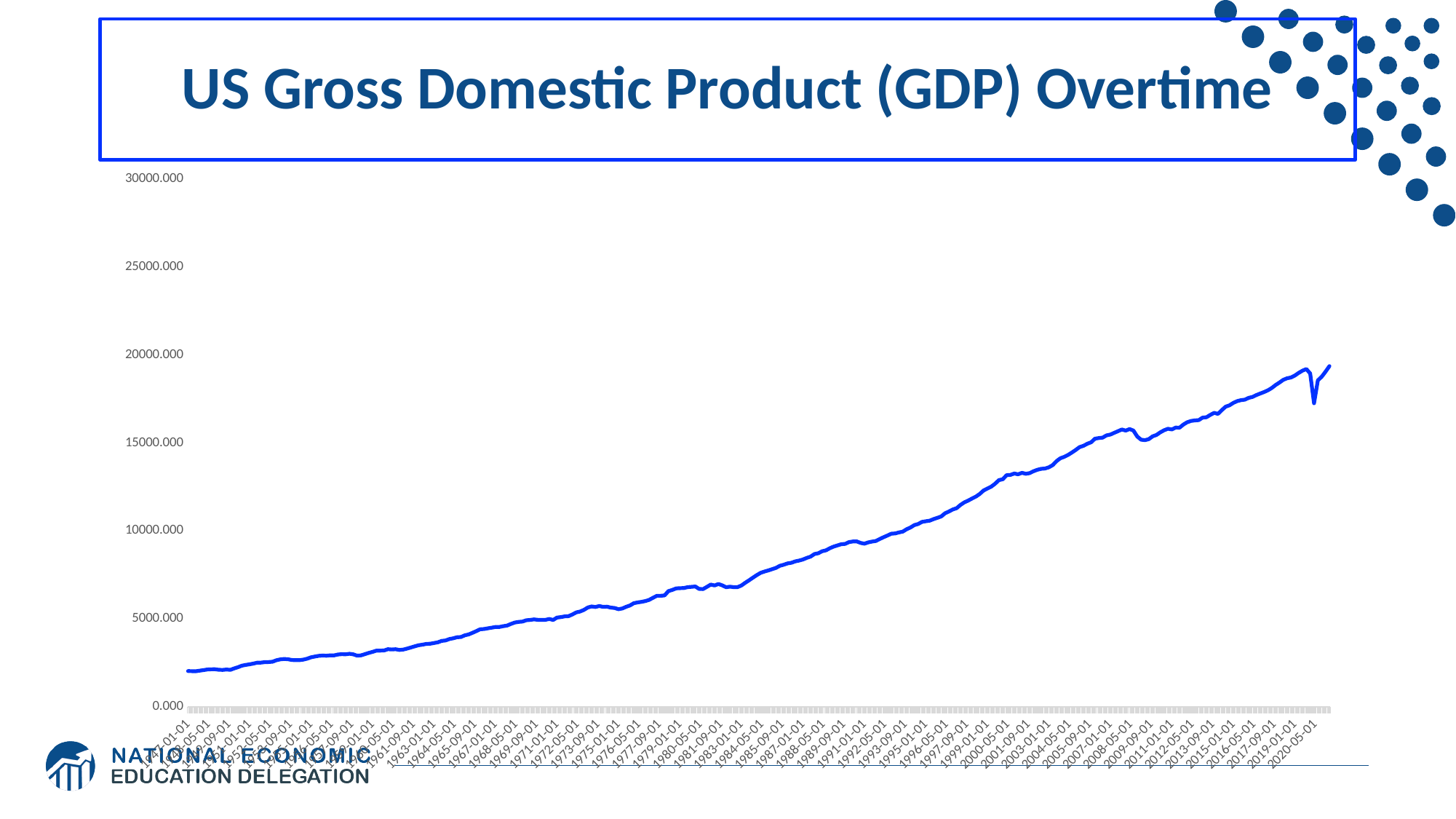
Is the value for 1984-05-01 greater or less than 10000.000? less Do the values generally rise or fall along the x axis from left to right? rise How many lines are plotted on the chart? 1 What is the title of the chart? US Gross Domestic Product (GDP) Overtime Is the value for 2004-01-01 greater or less than 10000.000? greater Is the value at the right end of the line (2020-05-01) greater or less than 20000.000? less What is the highest tick value shown on the y axis? 30000.000 What kind of chart is shown on the slide? line chart